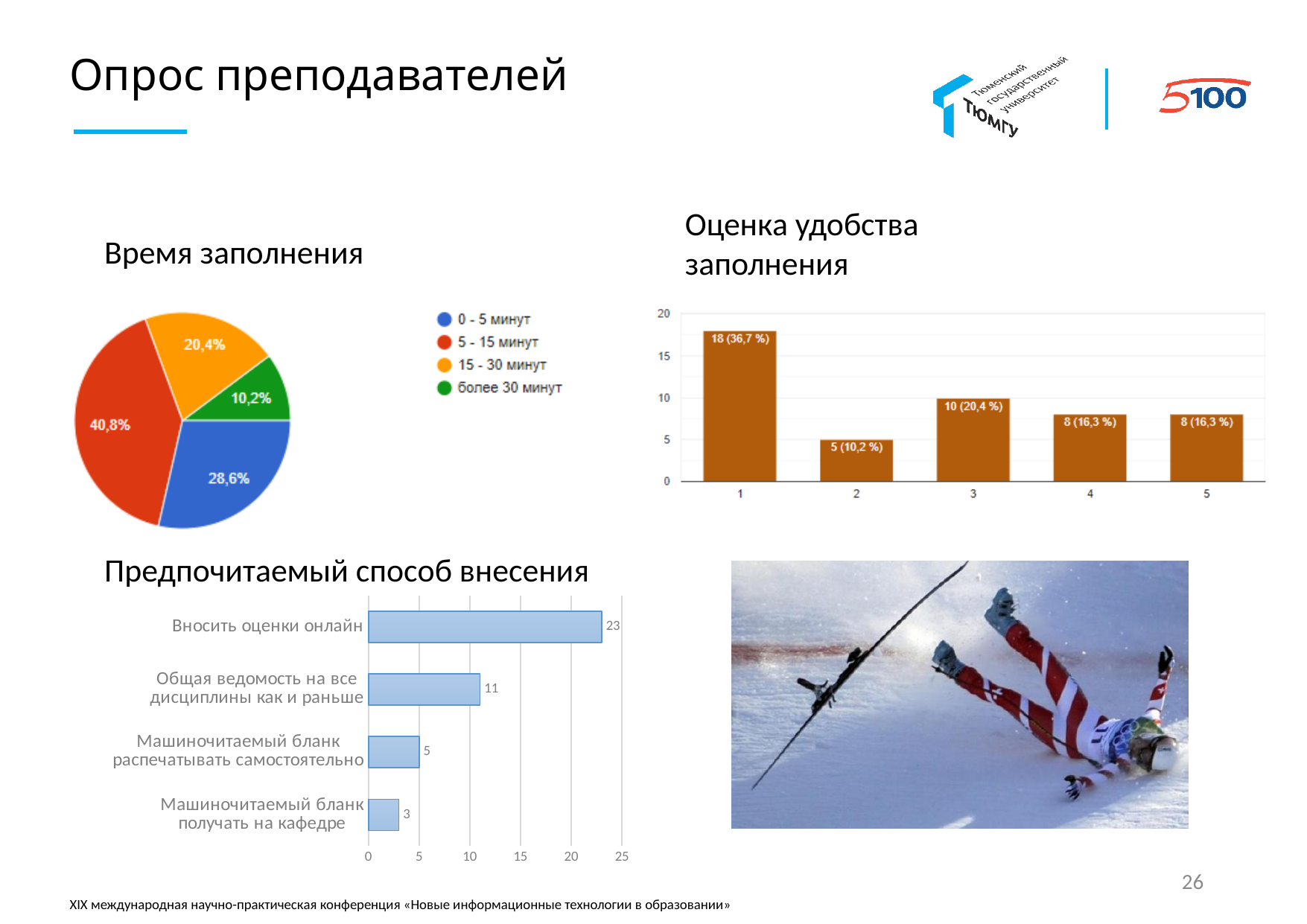
In the 'Время заполнения' pie chart, which category has the smallest share? более 30 минут What kind of chart is 'Оценка удобства заполнения'? Bar chart In the 'Оценка удобства заполнения' chart, how many rating categories are shown on the x axis? 5 In the 'Время заполнения' pie chart, what share corresponds to '5 - 15 минут'? 40,8% In the 'Оценка удобства заполнения' chart, which rating has the lowest count? 2 In the 'Время заполнения' pie chart, which is larger: the share for '0 - 5 минут' or for '15 - 30 минут'? 0 - 5 минут In the 'Предпочитаемый способ внесения' chart, what is the difference between 'Вносить оценки онлайн' and 'Общая ведомость на все дисциплины как и раньше'? 12 In the 'Оценка удобства заполнения' chart, what is the difference between the counts for rating 1 and rating 3? 8 In the 'Время заполнения' pie chart, how many categories does the legend list? 4 In the 'Предпочитаемый способ внесения' chart, what is the value for 'Вносить оценки онлайн'? 23 In the 'Оценка удобства заполнения' chart, what is the value for rating 1? 18 (36,7 %) In the 'Предпочитаемый способ внесения' chart, which option has the lowest value? Машиночитаемый бланк получать на кафедре